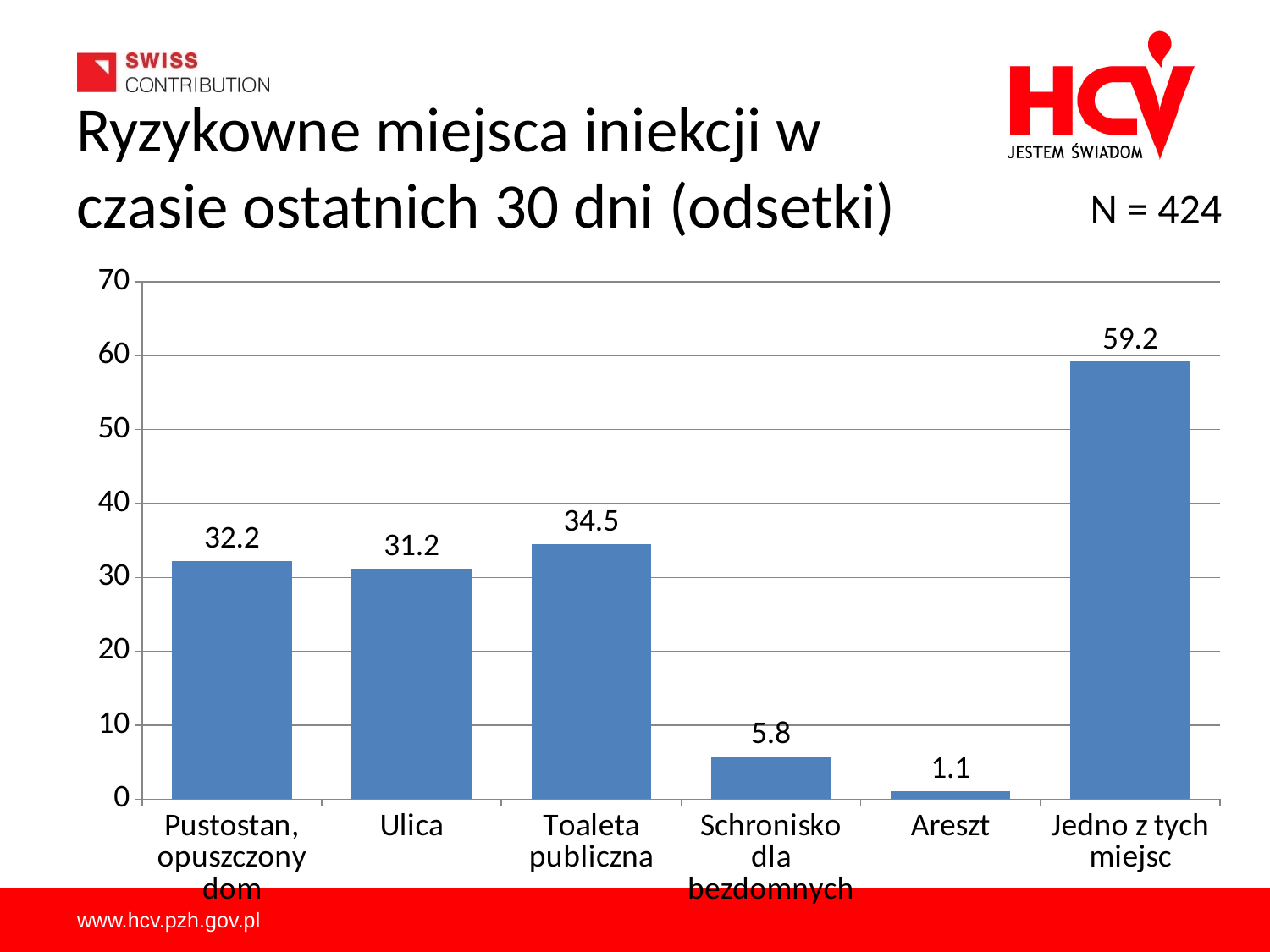
What is the value for Toaleta publiczna? 34.5 How many categories are shown on the x axis? 6 Which category has the lowest value? Areszt What is the difference between the values for Jedno z tych miejsc and Toaleta publiczna? 24.7 What is the value for Areszt? 1.1 Which category has the highest value? Jedno z tych miejsc What is the value for Ulica? 31.2 What kind of chart is shown on the slide? bar chart What is the value for Schronisko dla bezdomnych? 5.8 What sample size (N) is stated on the slide? N = 424 Is the value for Toaleta publiczna greater or less than 30? greater Which is larger, the value for Pustostan, opuszczony dom or the value for Ulica? Pustostan, opuszczony dom